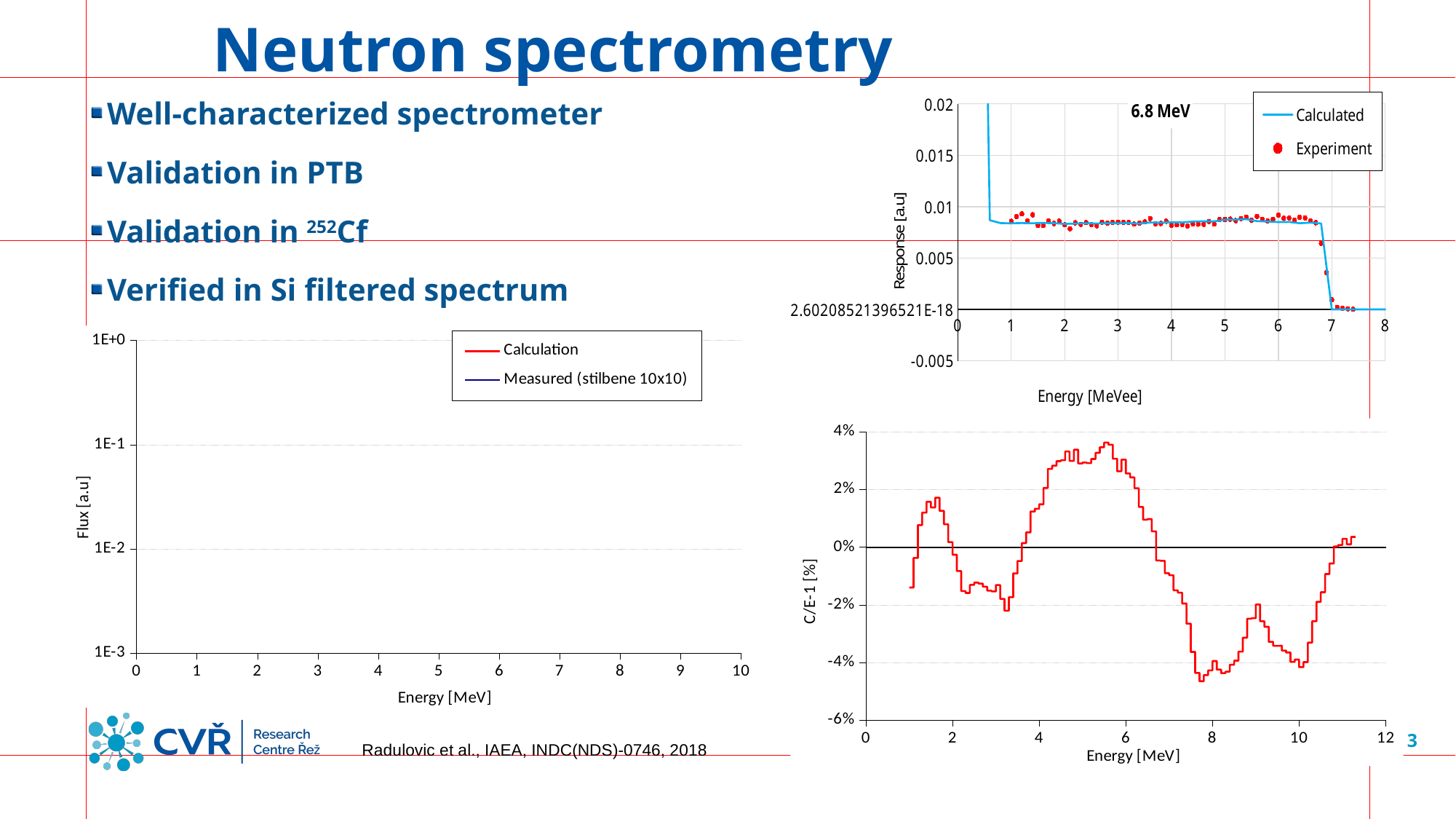
What energy value is annotated at the top of the top-right chart? 6.8 MeV What kind of chart is the bottom-right chart? line chart In the bottom-right chart, is the C/E-1 value at 8 MeV greater or less than -2%? less In the top-right chart, is the Calculated response at 7.5 MeVee greater or less than 0.005? less In the bottom-left chart, what is the highest tick value shown on the x axis? 10 In the bottom-right chart, is the C/E-1 value at 3 MeV greater or less than 0%? less In the top-right chart, how many series does the legend list? 2 In the bottom-left chart, how many series does the legend list? 2 In the top-right chart, what are the two legend entries? Calculated and Experiment In the top-right chart, does the response rise or fall sharply around 7 MeVee? fall